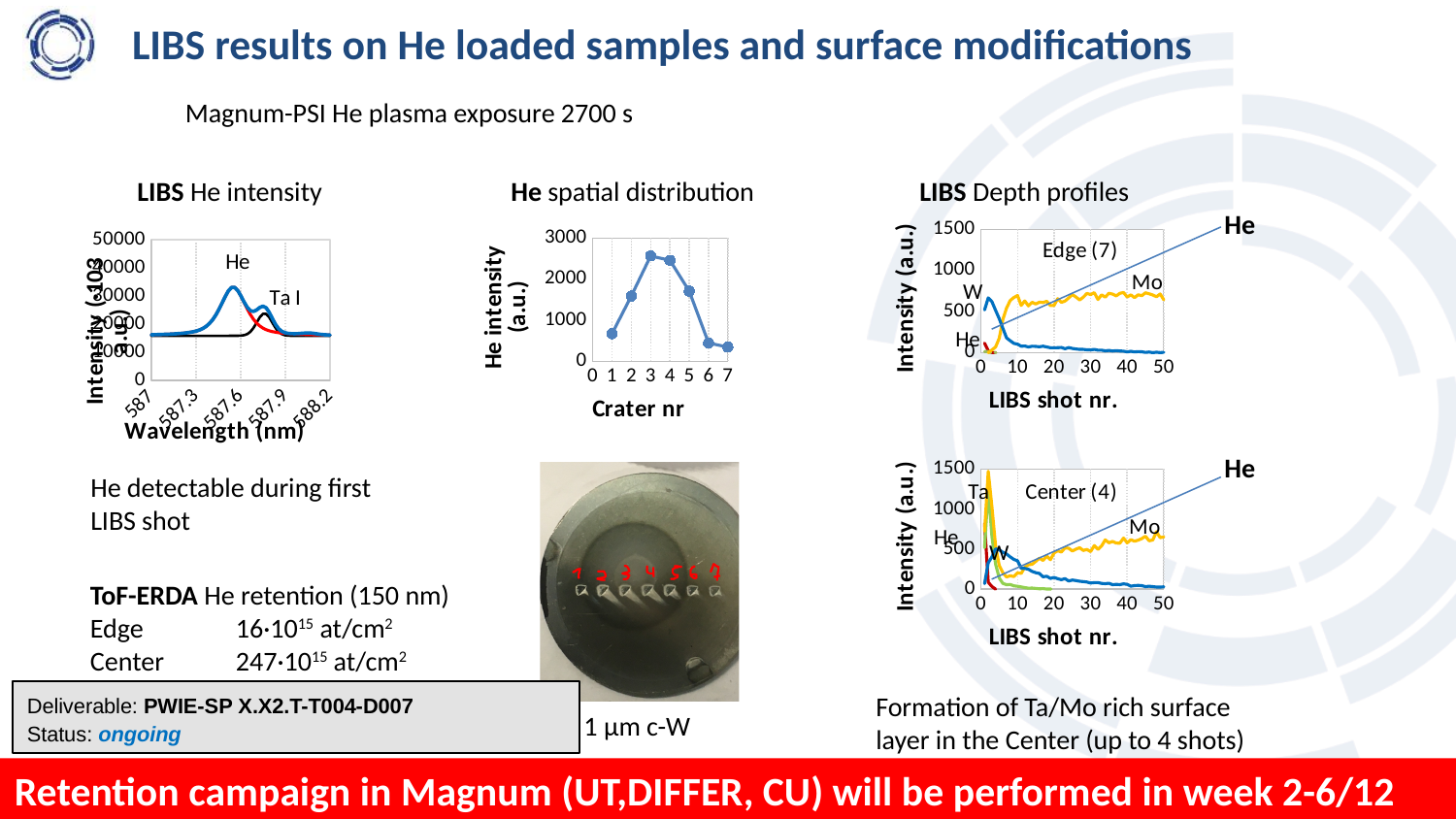
In the 'He spatial distribution' chart, which has the larger He intensity, crater 2 or crater 6? crater 2 In the 'LIBS Depth profiles' Edge (7) chart, does the Mo intensity rise or fall as the LIBS shot number increases? rise In the 'LIBS He intensity' chart, what is the x-axis title? Wavelength (nm) In the 'LIBS Depth profiles' Edge (7) chart, does the He intensity rise or fall as the LIBS shot number increases? fall In the 'He spatial distribution' chart, is the He intensity for crater 1 greater or less than 1000? less In the 'He spatial distribution' chart, what kind of chart is it? line chart In the 'LIBS Depth profiles' Center (4) chart, is the Mo intensity at LIBS shot 50 greater or less than 500? greater In the 'He spatial distribution' chart, which crater number has the highest He intensity? 3 In the 'LIBS He intensity' chart, what is the highest value shown on the y axis? 50000 In the 'He spatial distribution' chart, how many crater data points are plotted? 7 In the 'He spatial distribution' chart, what is the x-axis title? Crater nr In the 'He spatial distribution' chart, is the He intensity for crater 3 greater or less than 2000? greater